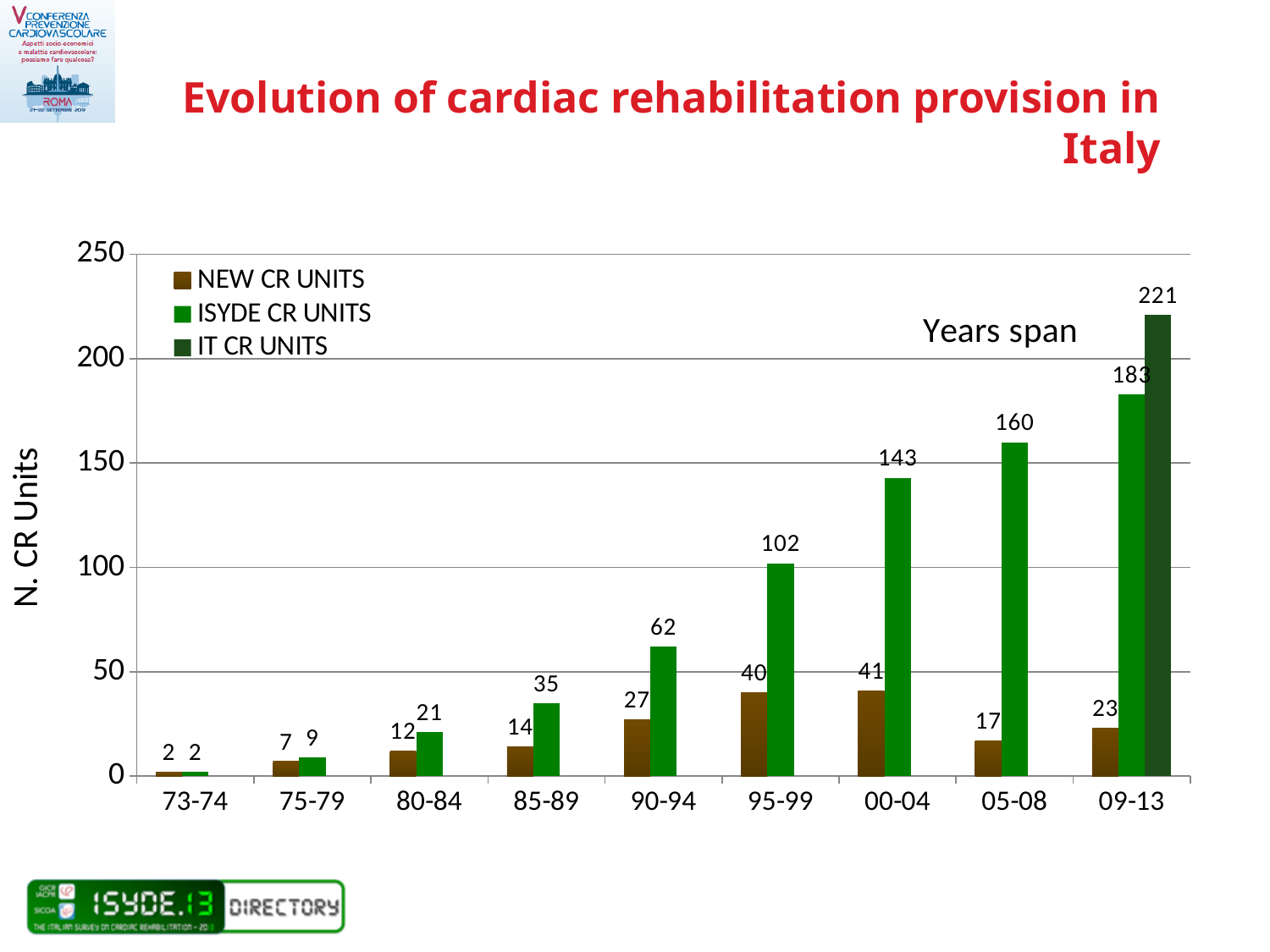
Do the ISYDE CR UNITS values rise or fall from 73-74 to 09-13? rise In which years span is the ISYDE CR UNITS value highest? 09-13 In which years span is the NEW CR UNITS value lowest? 73-74 What is the value for ISYDE CR UNITS in 09-13? 183 What kind of chart is shown on the slide? bar chart Is the value for ISYDE CR UNITS in 95-99 greater or less than 100? greater What is the value for IT CR UNITS in 09-13? 221 What is the value for NEW CR UNITS in 95-99? 40 What is the difference between ISYDE CR UNITS in 05-08 and in 00-04? 17 How many years spans are shown on the x axis? 9 How many series does the legend list? 3 Which is larger: NEW CR UNITS in 00-04 or NEW CR UNITS in 05-08? NEW CR UNITS in 00-04